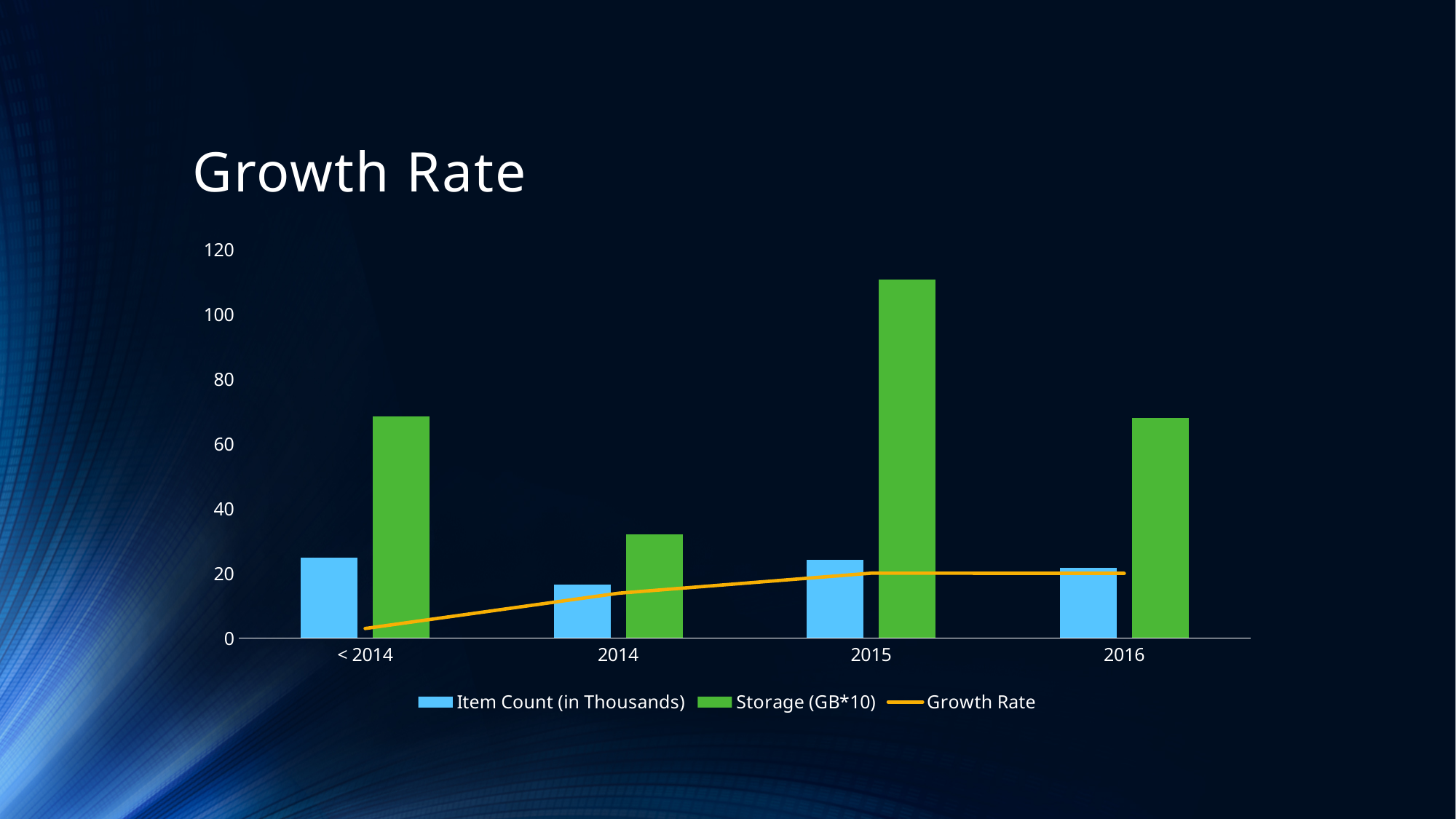
What is the title of the chart? Growth Rate Is the Item Count (in Thousands) value for < 2014 greater or less than 20? greater How many categories are shown on the x axis? 4 Which is larger for 2014: Item Count (in Thousands) or Storage (GB*10)? Storage (GB*10) Which category has the highest Storage (GB*10) value? 2015 How many series does the legend list? 3 Does the Growth Rate line rise or fall from < 2014 to 2015? Rises Is the Storage (GB*10) value for 2014 greater or less than 40? less Is the Storage (GB*10) value for 2015 greater or less than 100? greater Which category has the lowest Item Count (in Thousands) value? 2014 What kind of chart is shown on the slide? Bar chart with a line Which category has the lowest Storage (GB*10) value? 2014